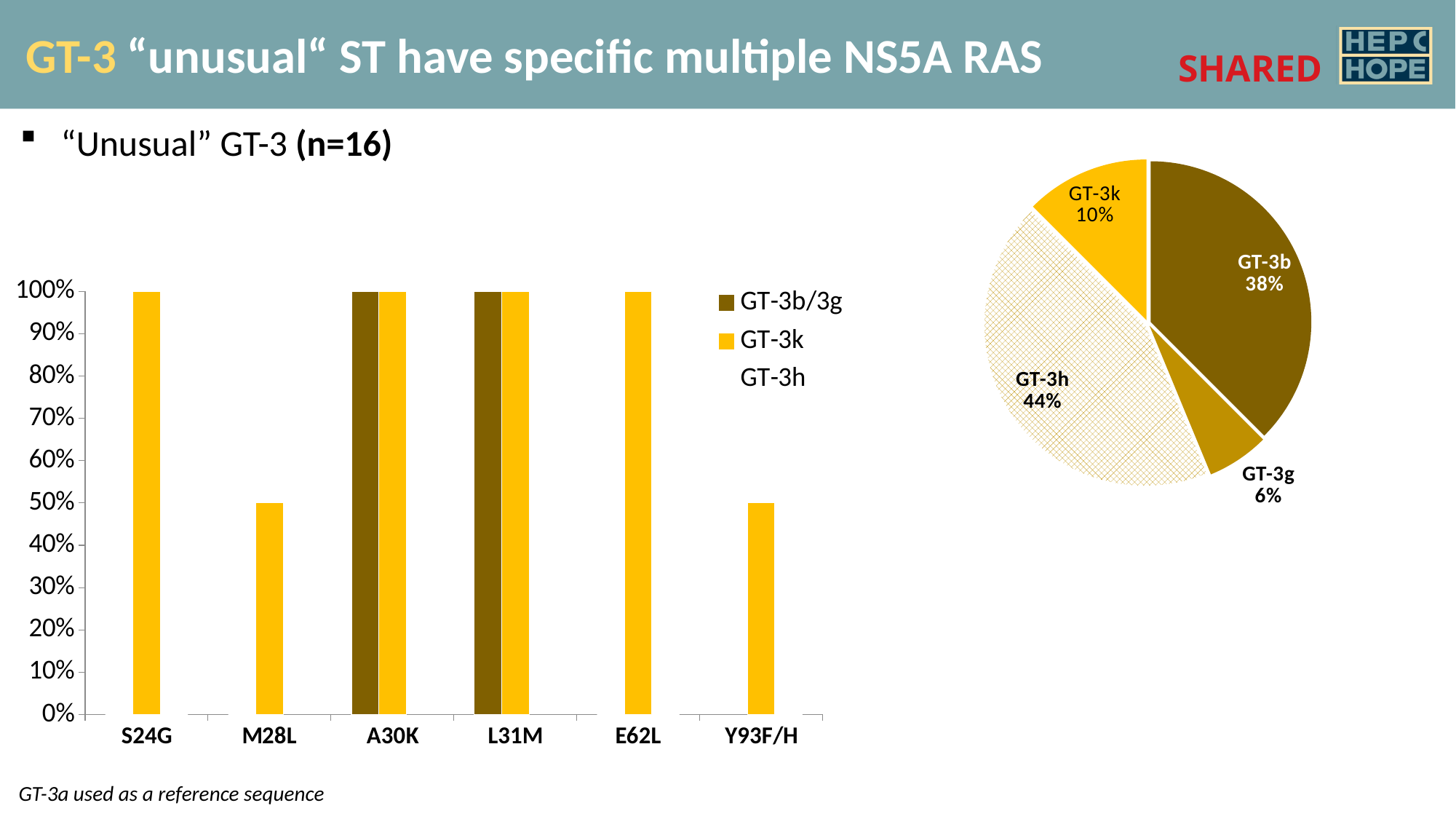
On the bar chart on the left, what is the value of the GT-3b/3g bar for A30K? 100% On the pie chart on the right, which subtype has the smallest slice? GT-3g On the pie chart on the right, what share does GT-3h have? 44% On the pie chart on the right, which subtype has the largest slice? GT-3h On the bar chart on the left, how many RAS categories are shown on the x axis? 6 On the bar chart on the left, what is the value of the GT-3k bar for M28L? 50% What kind of chart is the chart on the left of the slide? bar chart On the bar chart on the left, is the GT-3k value for S24G larger or smaller than the GT-3k value for M28L? larger On the bar chart on the left, what is the value of the GT-3k bar for Y93F/H? 50% On the pie chart on the right, what is the difference between the GT-3b share and the GT-3k share? 28% On the bar chart on the left, what is the difference between the GT-3k value for E62L and the GT-3k value for Y93F/H? 50% On the bar chart on the left, how many series does the legend list? 3